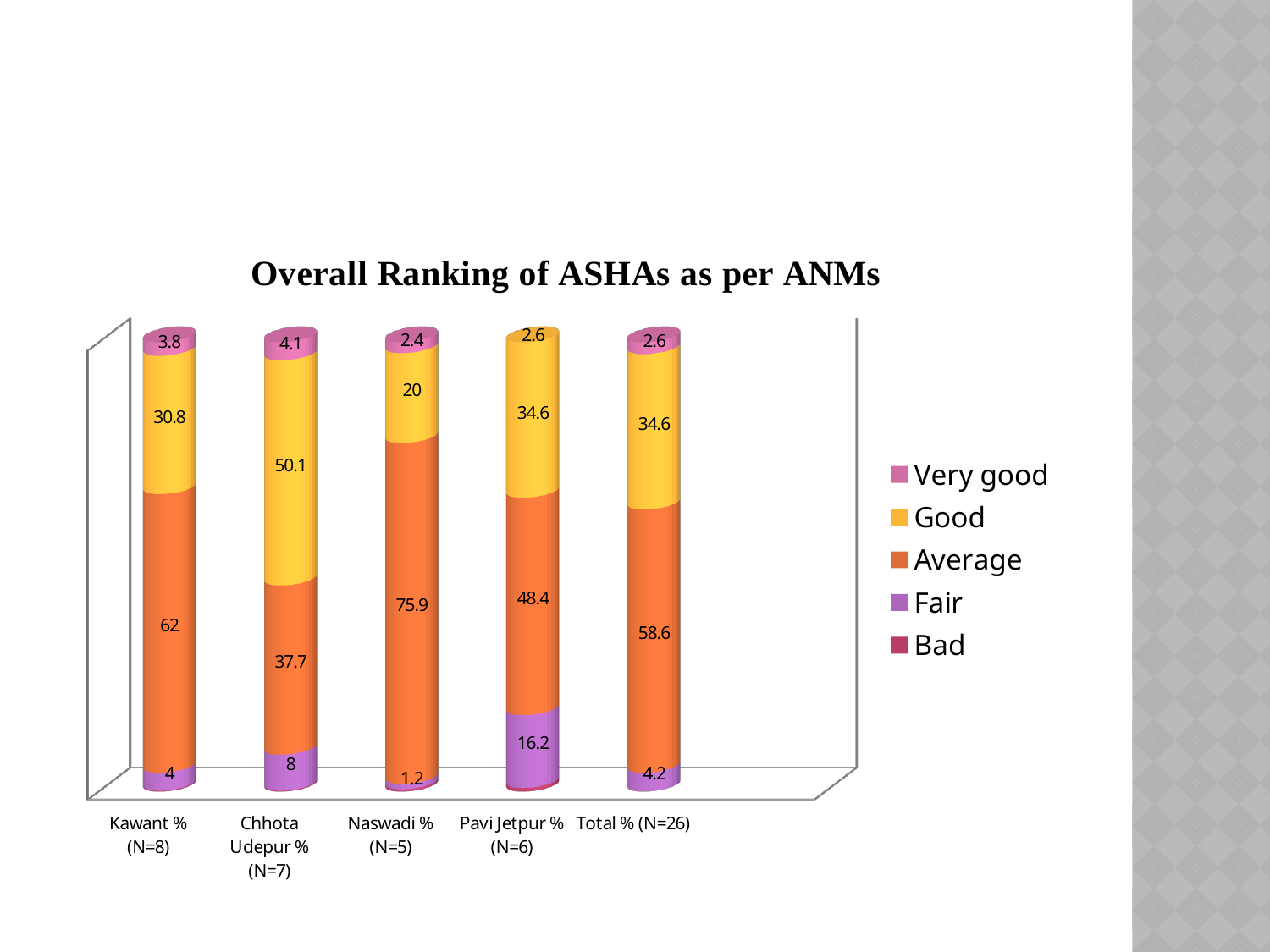
What is the Fair value for Pavi Jetpur % (N=6)? 16.2 What is the difference between the Average values for Kawant % (N=8) and Chhota Udepur % (N=7)? 24.3 What is the Good value for Chhota Udepur % (N=7)? 50.1 Which category has the lowest Good value? Naswadi % (N=5) What is the Very good value for Total % (N=26)? 2.6 What type of chart is shown on the slide? stacked bar chart Which is larger, the Fair value for Chhota Udepur % (N=7) or the Fair value for Kawant % (N=8)? Chhota Udepur % (N=7) Which category has the highest Average value? Naswadi % (N=5) What is the title of the chart? Overall Ranking of ASHAs as per ANMs How many series does the legend list? 5 What is the Average value for Naswadi % (N=5)? 75.9 How many categories are shown on the x axis? 5